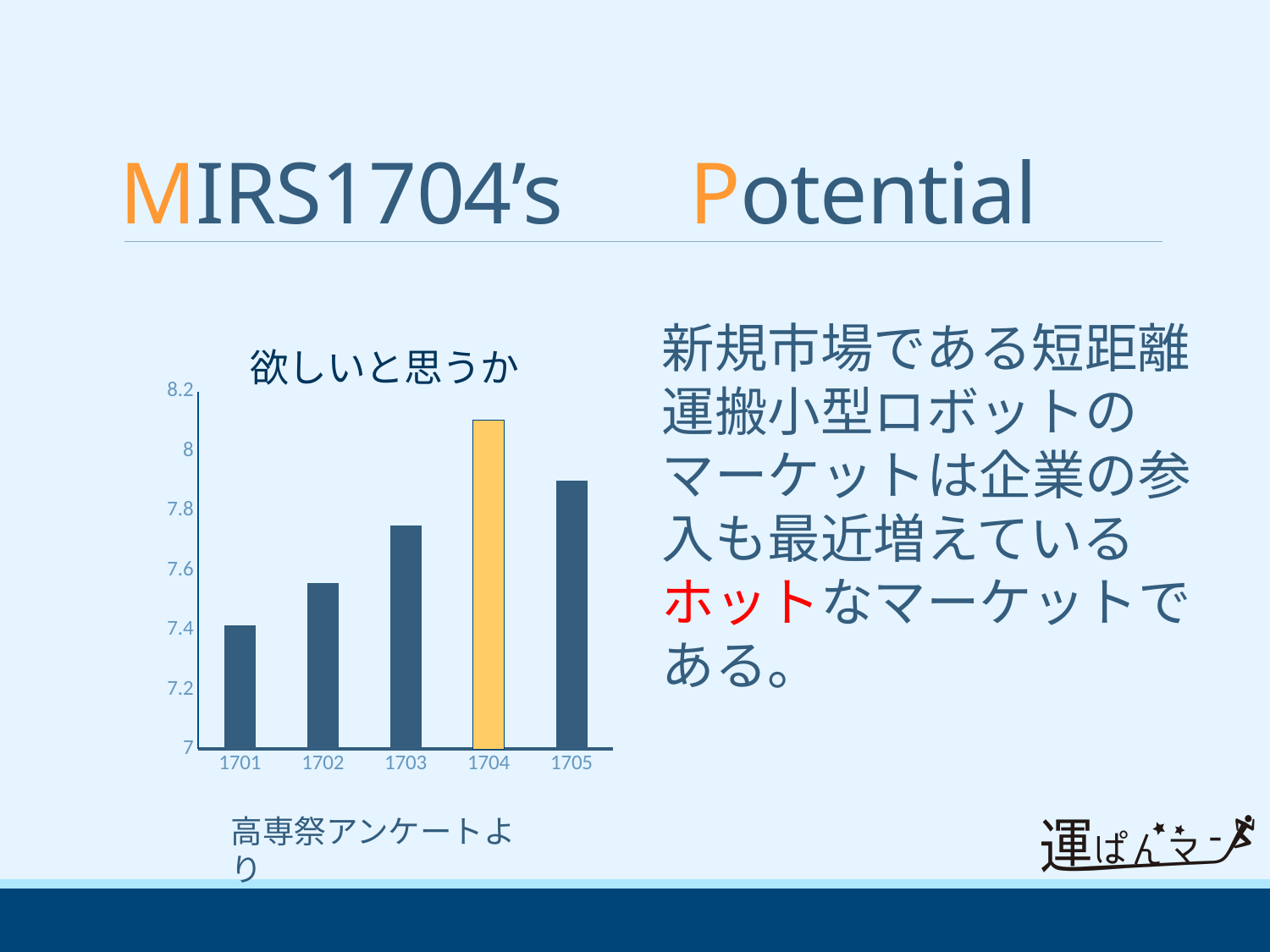
Do the values rise or fall from 1701 to 1704? rise Is the value for 1704 greater or less than 8? greater Which has the larger value, 1702 or 1703? 1703 Which category's bar is highlighted in orange? 1704 What is the title of the chart? 欲しいと思うか Which has the larger value, 1704 or 1705? 1704 How many categories are shown on the x axis of the chart? 5 What kind of chart is shown on the slide? bar chart Is the value for 1705 greater or less than 7.8? greater Which category has the lowest value in the chart? 1701 Is the value for 1701 greater or less than 7.6? less Which category has the highest value in the chart? 1704